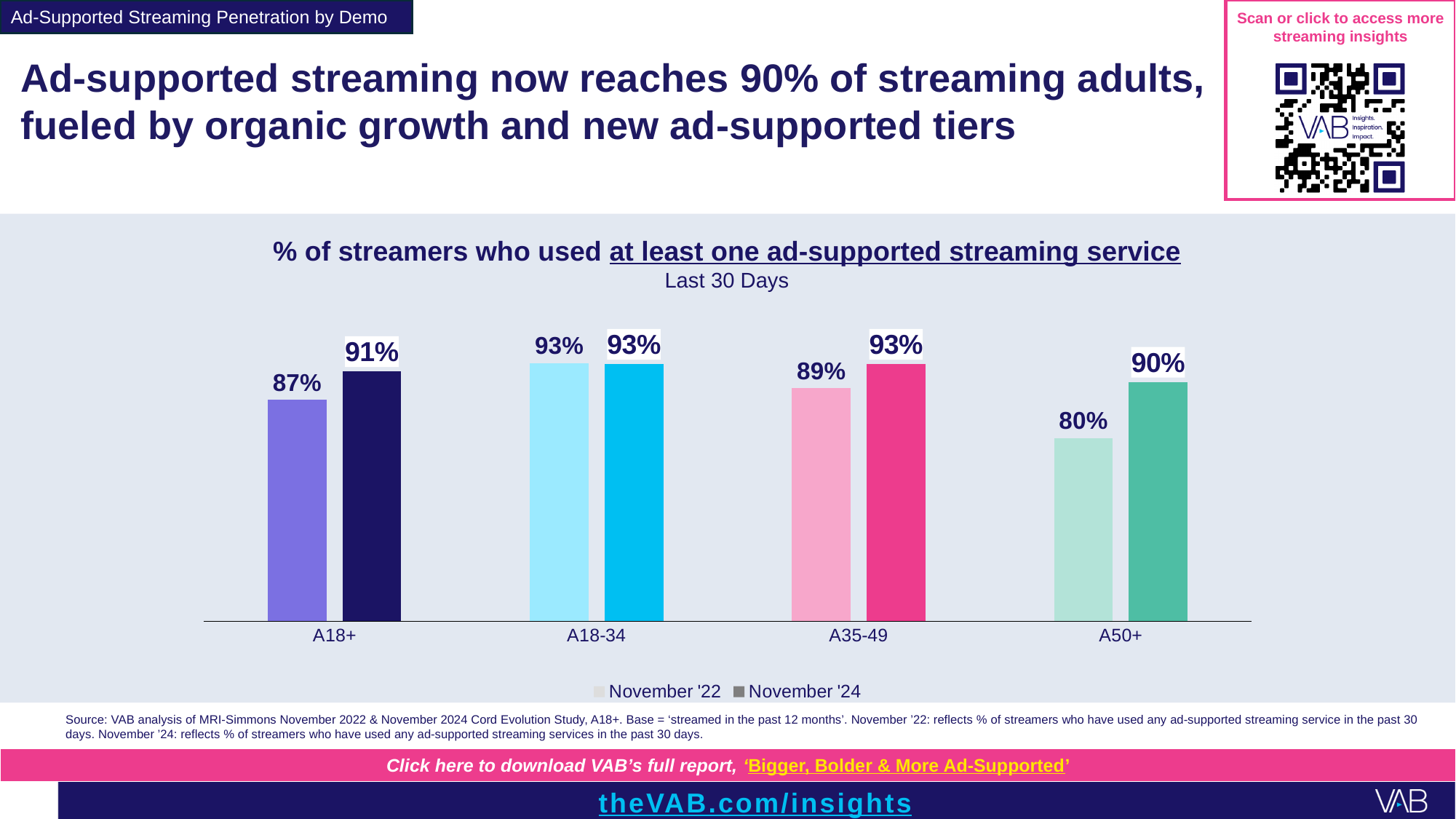
What is the November '22 value for A18+? 87% How many age groups are shown on the x axis? 4 What time period does the chart subtitle specify? Last 30 Days What is the November '24 value for A50+? 90% What is the November '22 value for A35-49? 89% What is the difference between the November '24 and November '22 values for A18+? 4 percentage points How many series does the legend list? 2 Which is larger for A35-49: the November '22 value or the November '24 value? November '24 Which age group has the lowest November '22 value? A50+ What is the difference between the November '24 and November '22 values for A50+? 10 percentage points What kind of chart is shown on the slide? Bar chart Which age group has the highest November '22 value? A18-34